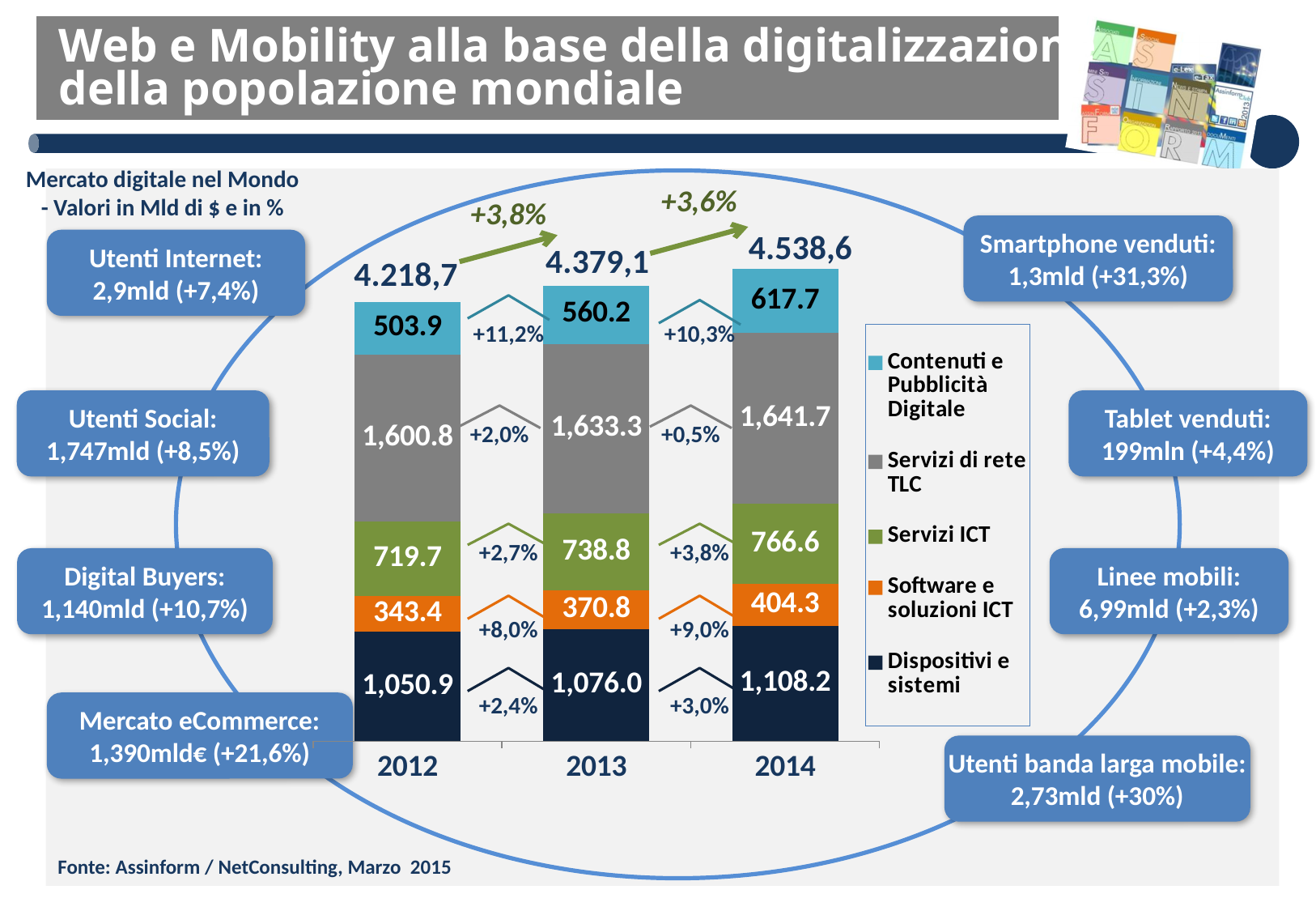
How many years are shown on the x axis? 3 What is the value for Dispositivi e sistemi in 2014? 1,108.2 What kind of chart is shown? Stacked bar chart How many series does the legend list? 5 Which series has the smallest value in 2014? Software e soluzioni ICT What is the difference between the Software e soluzioni ICT values for 2014 and 2013? 33.5 What growth percentage is shown for the total from 2013 to 2014? +3,6% What is the value for Contenuti e Pubblicità Digitale in 2012? 503.9 Which is larger in 2012: Servizi ICT or Contenuti e Pubblicità Digitale? Servizi ICT What is the value for Servizi ICT in 2013? 738.8 What is the total of the stacked bar for 2014? 4.538,6 Which year has the highest total value? 2014